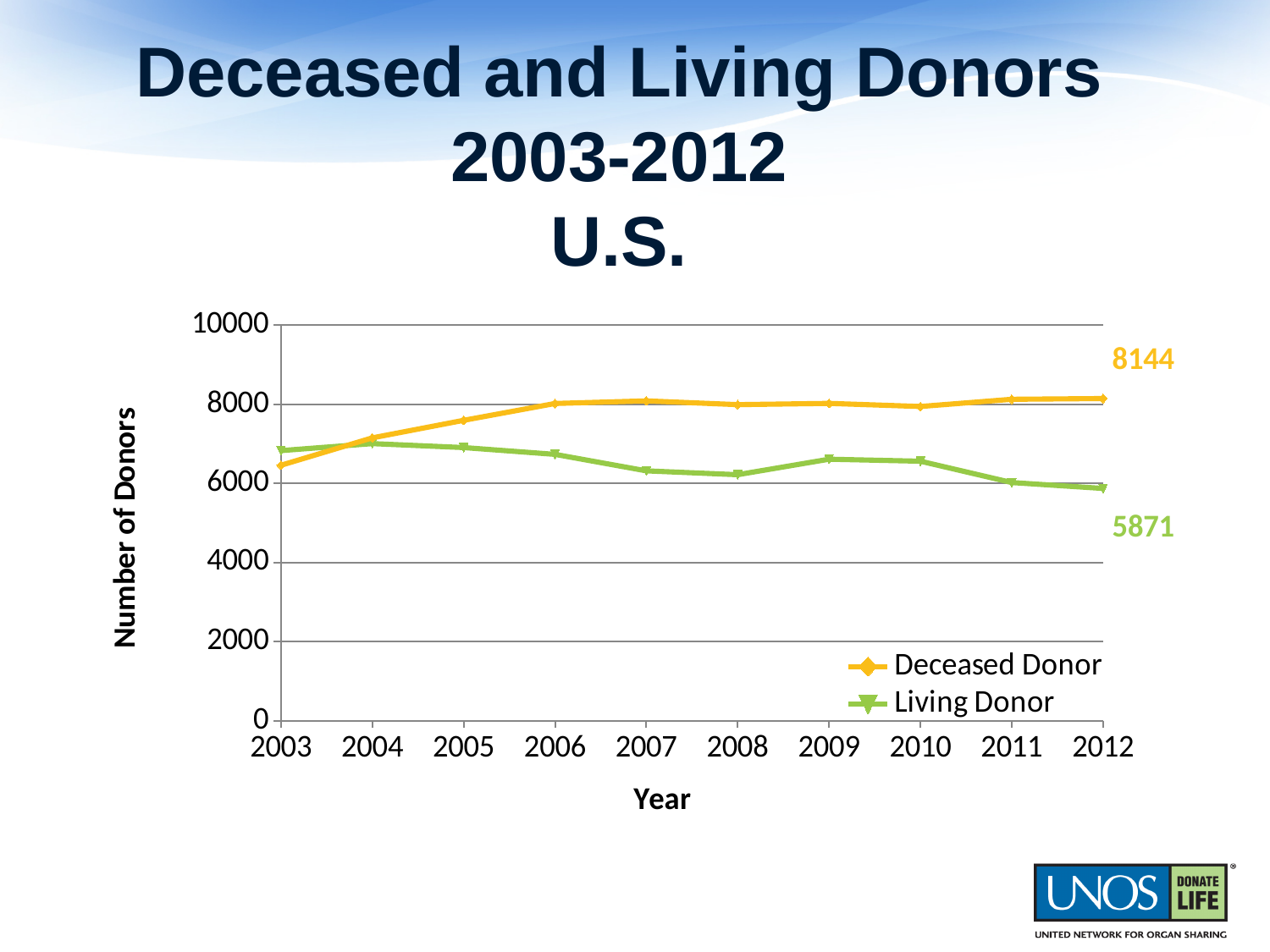
In 2012, which series has the larger value, Deceased Donor or Living Donor? Deceased Donor Is the value for Deceased Donor in 2006 greater or less than 6000? greater In 2003, which series has the larger value, Deceased Donor or Living Donor? Living Donor What is the difference between the Deceased Donor and Living Donor values in 2012? 2273 Does the Living Donor series rise or fall from 2003 to 2012? fall How many years are shown on the x axis? 10 How many series does the legend list? 2 What kind of chart is shown on the slide? line chart What is the value for Deceased Donor in 2012? 8144 What is the value for Living Donor in 2012? 5871 Is the value for Deceased Donor in 2003 greater or less than 8000? less Is the value for Living Donor in 2008 greater or less than 8000? less